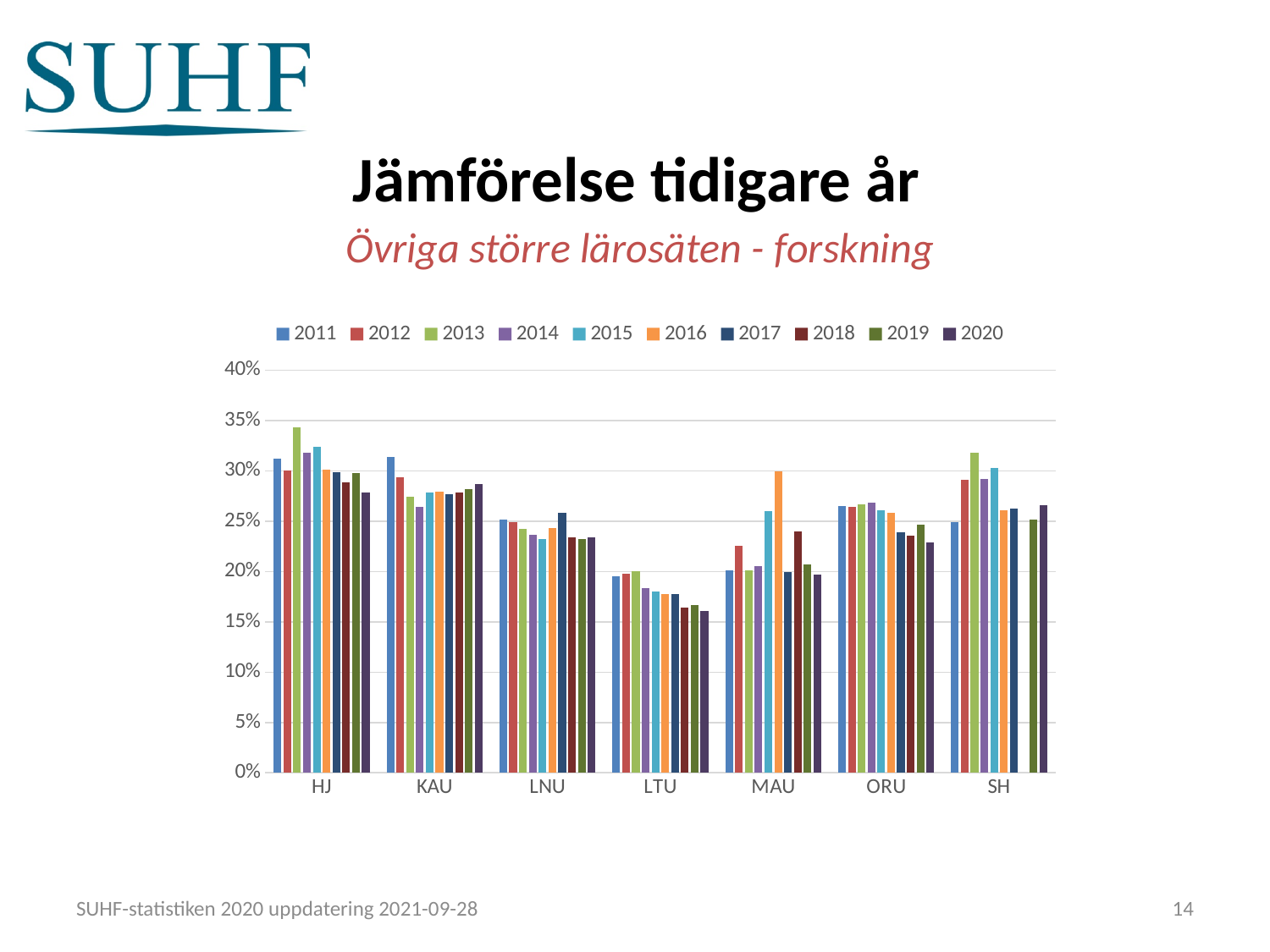
What kind of chart is shown on the slide? Bar chart Do the values for LTU generally rise or fall from 2011 to 2020? fall Which institution has the lowest values overall in the chart? LTU How many series does the legend list? 10 Is the value for ORU in 2020 greater or less than 25%? less Which is larger for MAU: the value for 2011 or the value for 2016? 2016 Which year has the highest value for HJ? 2013 Is the value for LTU in 2020 greater or less than 20%? less How many institutions (categories) are shown on the x axis? 7 Is the value for MAU in 2016 greater or less than 25%? greater What is the subtitle shown below the chart title? Övriga större lärosäten - forskning